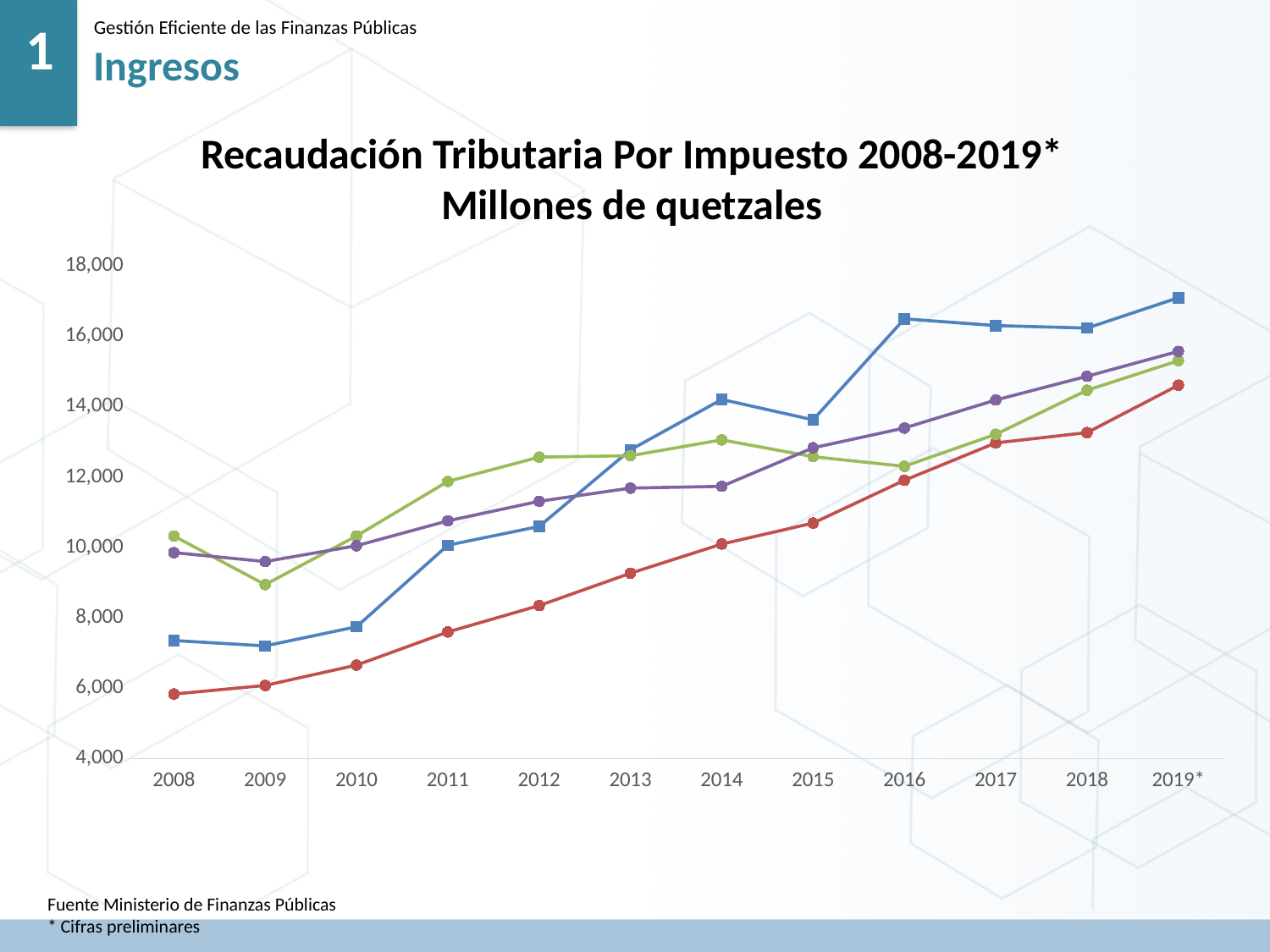
What is the title of the chart? Recaudación Tributaria Por Impuesto 2008-2019* Millones de quetzales Is the value of the red line in 2019* greater or less than 14,000? greater Which line has the lowest value in 2008? the red line What kind of chart is shown on the slide? line chart In 2008, which is higher, the green line or the blue line? the green line Is the value of the green line in 2009 greater or less than 10,000? less Is the value of the red line in 2008 greater or less than 6,000? less Which line has the highest value in 2019*? the blue line How many years are shown along the x axis of the chart? 12 Does the red line generally rise or fall from 2008 to 2019*? rise